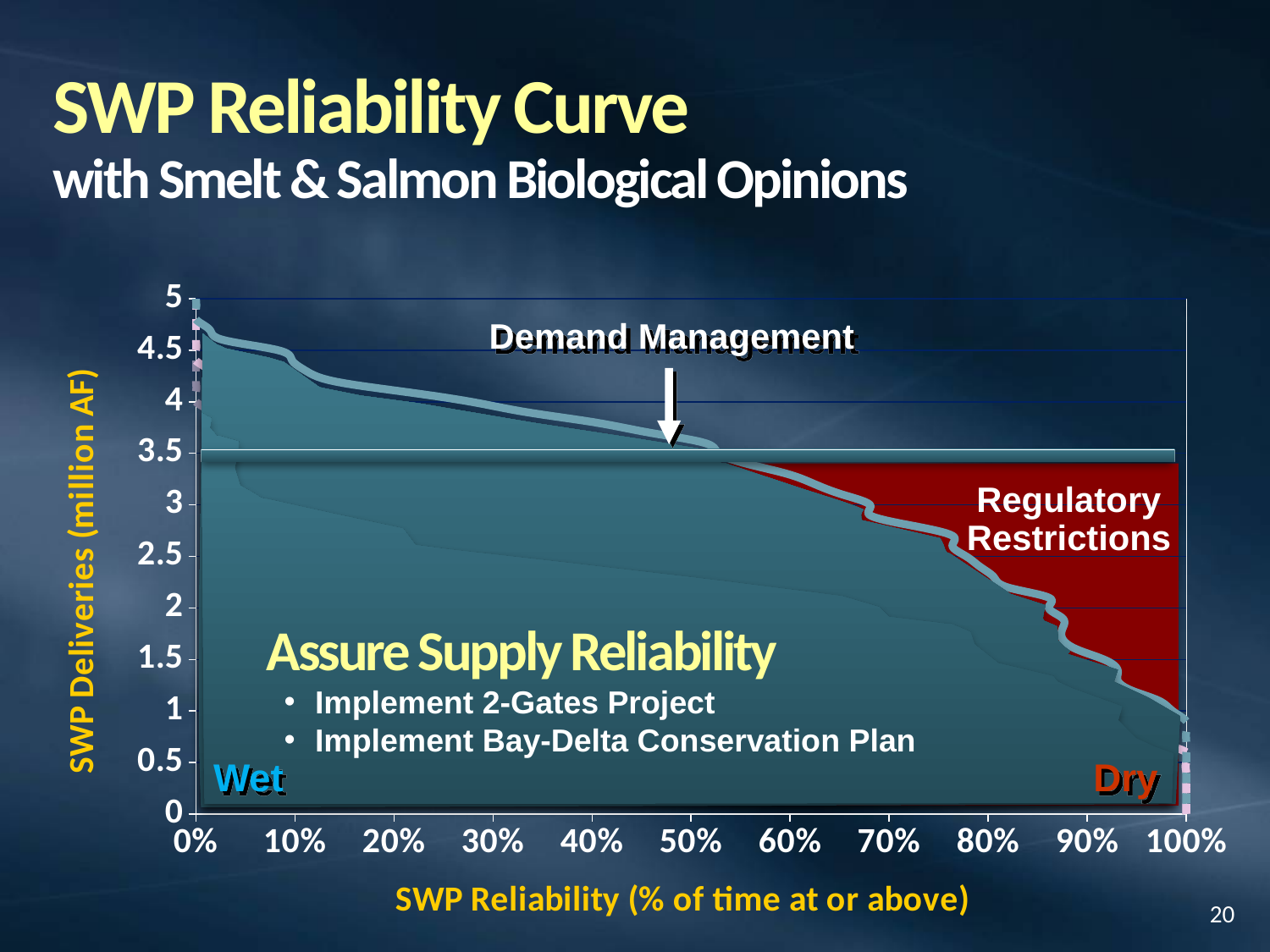
What kind of chart is shown on the slide? Area chart What does the red shaded area of the chart represent? Regulatory Restrictions Is the SWP delivery value at 90% reliability greater or less than 2 million AF? less Is the SWP delivery value at 20% reliability greater or less than 4 million AF? greater Is the SWP delivery value at 0% reliability greater or less than 4.5 million AF? greater Do SWP deliveries rise or fall as SWP reliability increases from 0% to 100%? Fall What is the label of the x axis? SWP Reliability (% of time at or above) At what delivery level (million AF) is the horizontal Demand Management line drawn? 3.5